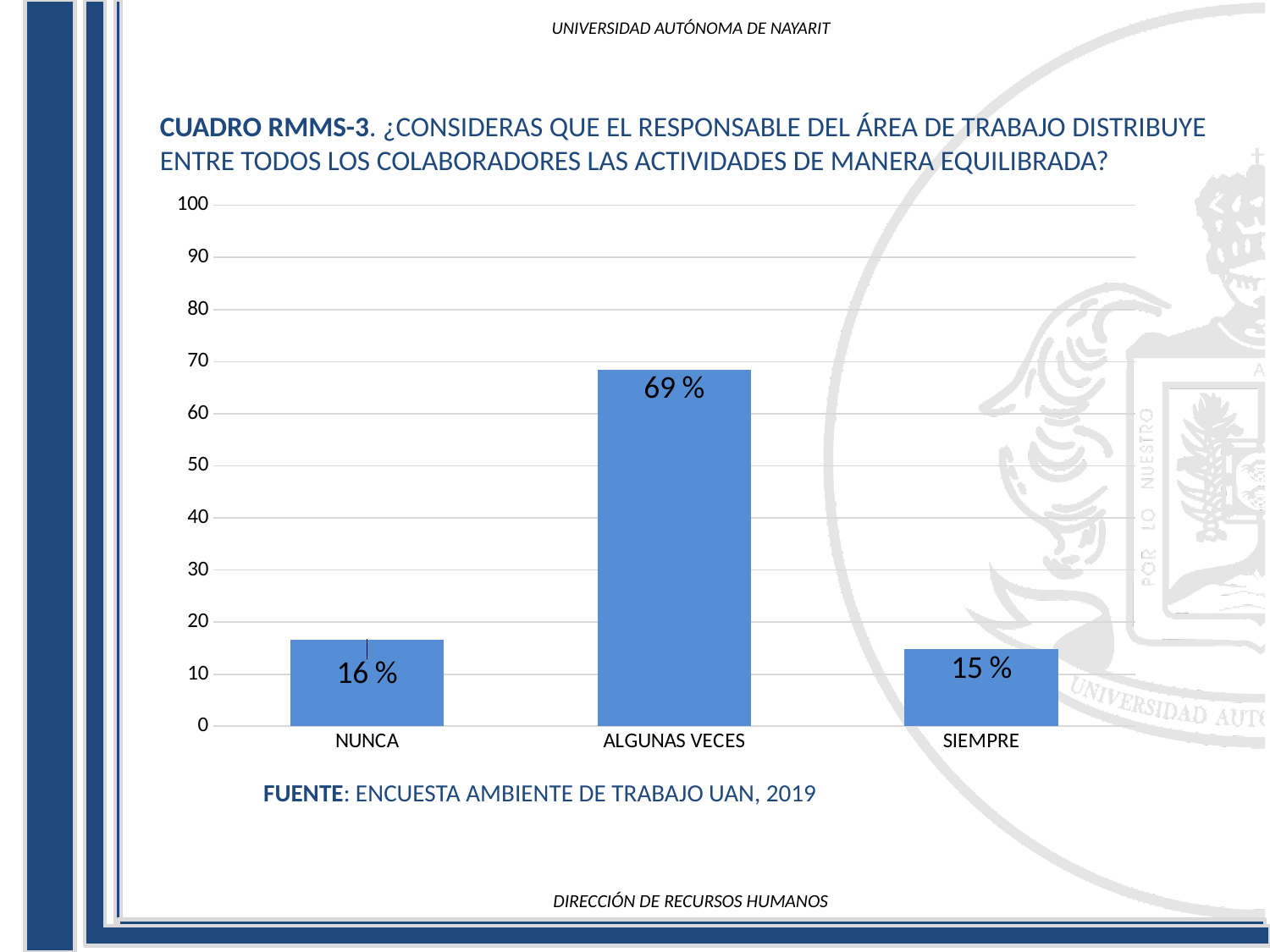
Is the value for SIEMPRE greater or less than 20? less What is the value for ALGUNAS VECES? 69 % What is the source cited below the chart? ENCUESTA AMBIENTE DE TRABAJO UAN, 2019 What is the value for NUNCA? 16 % How many categories are shown on the x axis? 3 What kind of chart is shown on the slide? bar chart What is the difference between the values for ALGUNAS VECES and NUNCA? 53 % What is the difference between the values for NUNCA and SIEMPRE? 1 % Is the value for ALGUNAS VECES greater or less than 60? greater Which category has the highest value? ALGUNAS VECES What is the highest value shown on the y axis? 100 What is the value for SIEMPRE? 15 %